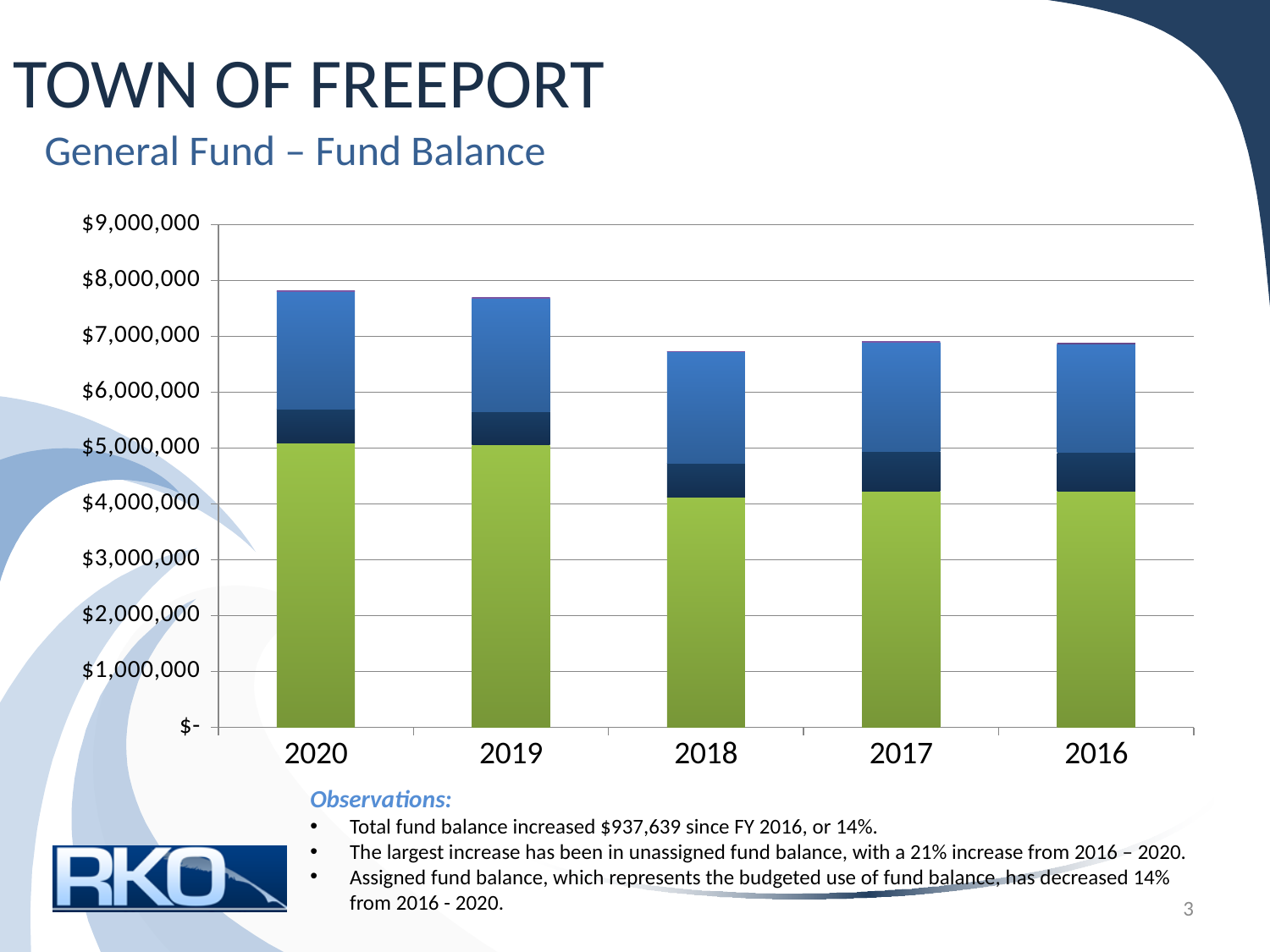
Which year has the highest total fund balance in the chart? 2020 Is the total fund balance for 2018 greater or less than $7,000,000? less Is the bottom (green) segment of the 2018 bar greater or less than $5,000,000? less Is the total fund balance for 2020 greater or less than $7,000,000? greater How many years are shown on the x axis of the chart? 5 What is the subtitle describing the chart on the slide? General Fund – Fund Balance What kind of chart is shown on the slide? Stacked bar chart Which has a larger total fund balance, 2020 or 2018? 2020 Which has a larger bottom (green) segment, 2019 or 2017? 2019 How many stacked segments make up each bar in the chart? 4